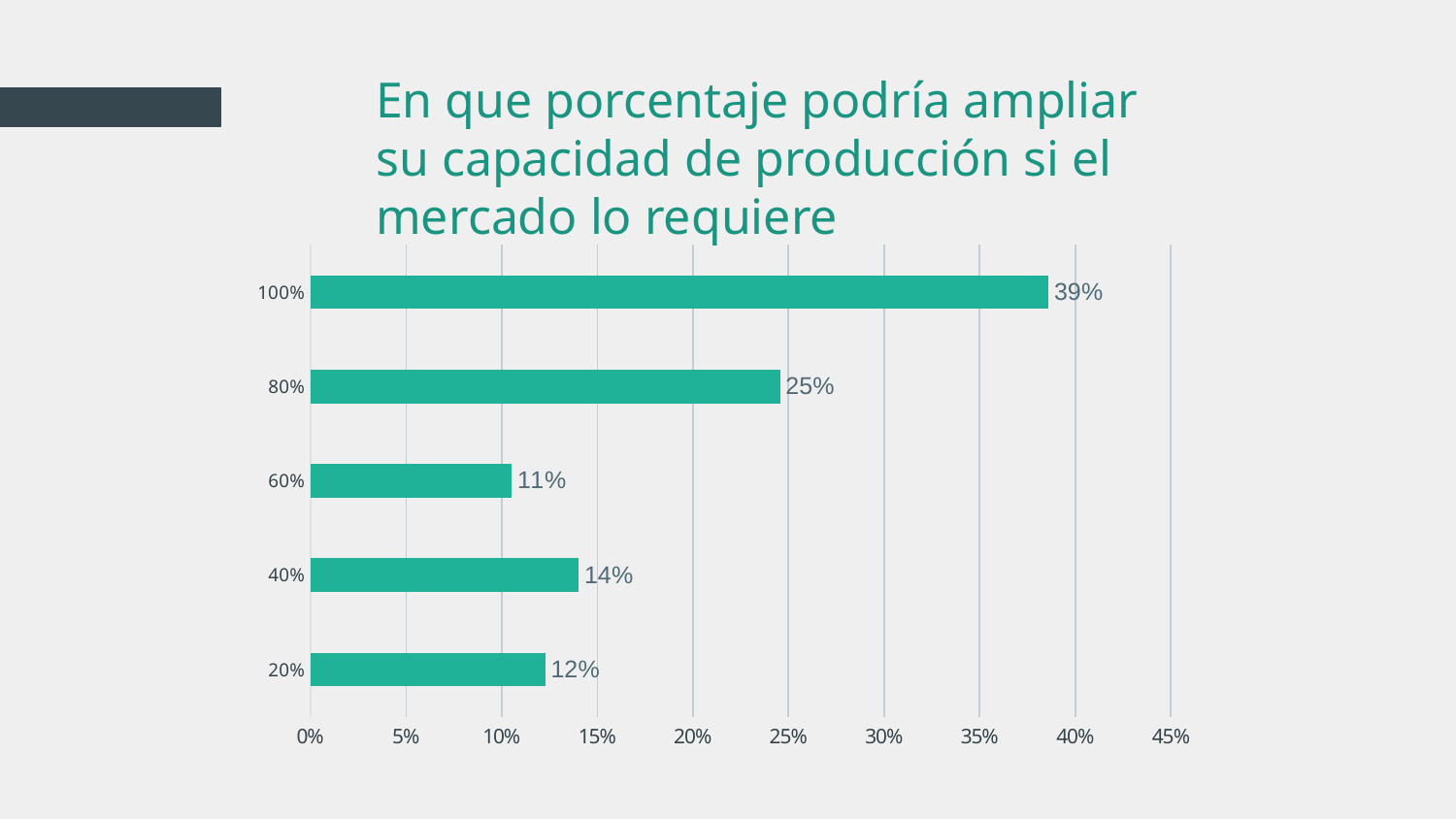
What is the value for the 40% category? 14% Which category has the highest value? 100% Which category has the lowest value? 60% Which is larger, the value for the 40% category or the value for the 20% category? 40% How many categories are shown in the chart? 5 What is the value for the 20% category? 12% What is the value for the 100% category? 39% What is the title of the chart? En que porcentaje podría ampliar su capacidad de producción si el mercado lo requiere What is the value for the 60% category? 11% What kind of chart is shown on the slide? Bar chart What is the difference between the values for the 100% and 80% categories? 14% What is the value for the 80% category? 25%